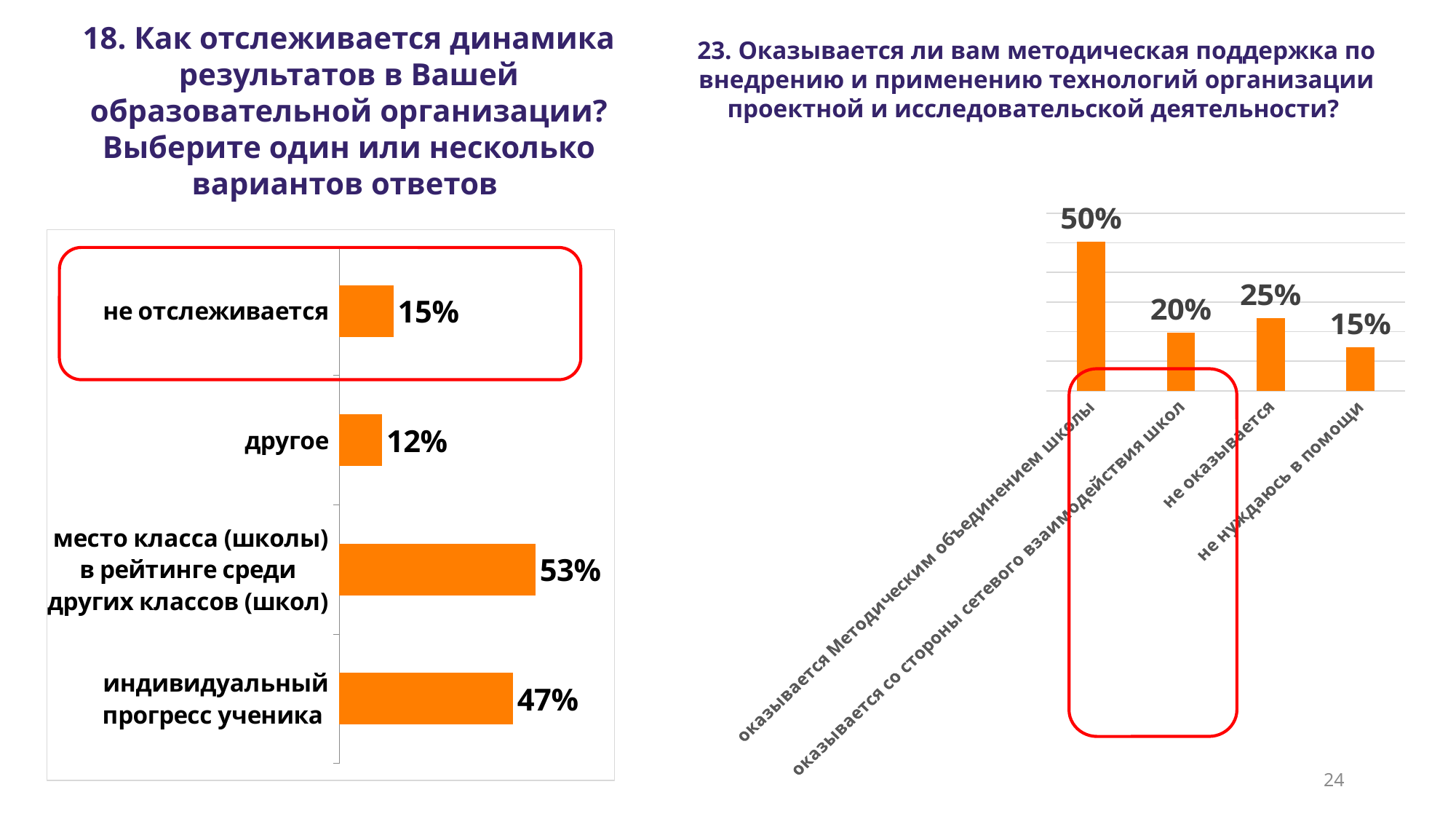
In the right chart (question 23), what is the value for "оказывается со стороны сетевого взаимодействия школ"? 20% In the right chart (question 23), what is the difference between the values for "оказывается Методическим объединением школы" and "не нуждаюсь в помощи"? 35% What type of chart is the left chart (question 18)? bar chart In the left chart (question 18), which category has the highest value? место класса (школы) в рейтинге среди других классов (школ) In the right chart (question 23), which category has the highest value? оказывается Методическим объединением школы In the left chart (question 18), which category has the lowest value? другое In the left chart (question 18), what is the value for "не отслеживается"? 15% In the left chart (question 18), what is the value for "индивидуальный прогресс ученика"? 47% In the left chart (question 18), what is the difference between the values for "место класса (школы) в рейтинге среди других классов (школ)" and "индивидуальный прогресс ученика"? 6% In the right chart (question 23), which is larger: the value for "не оказывается" or the value for "не нуждаюсь в помощи"? не оказывается In the right chart (question 23), what is the value for "не оказывается"? 25% In the left chart (question 18), how many categories are shown? 4